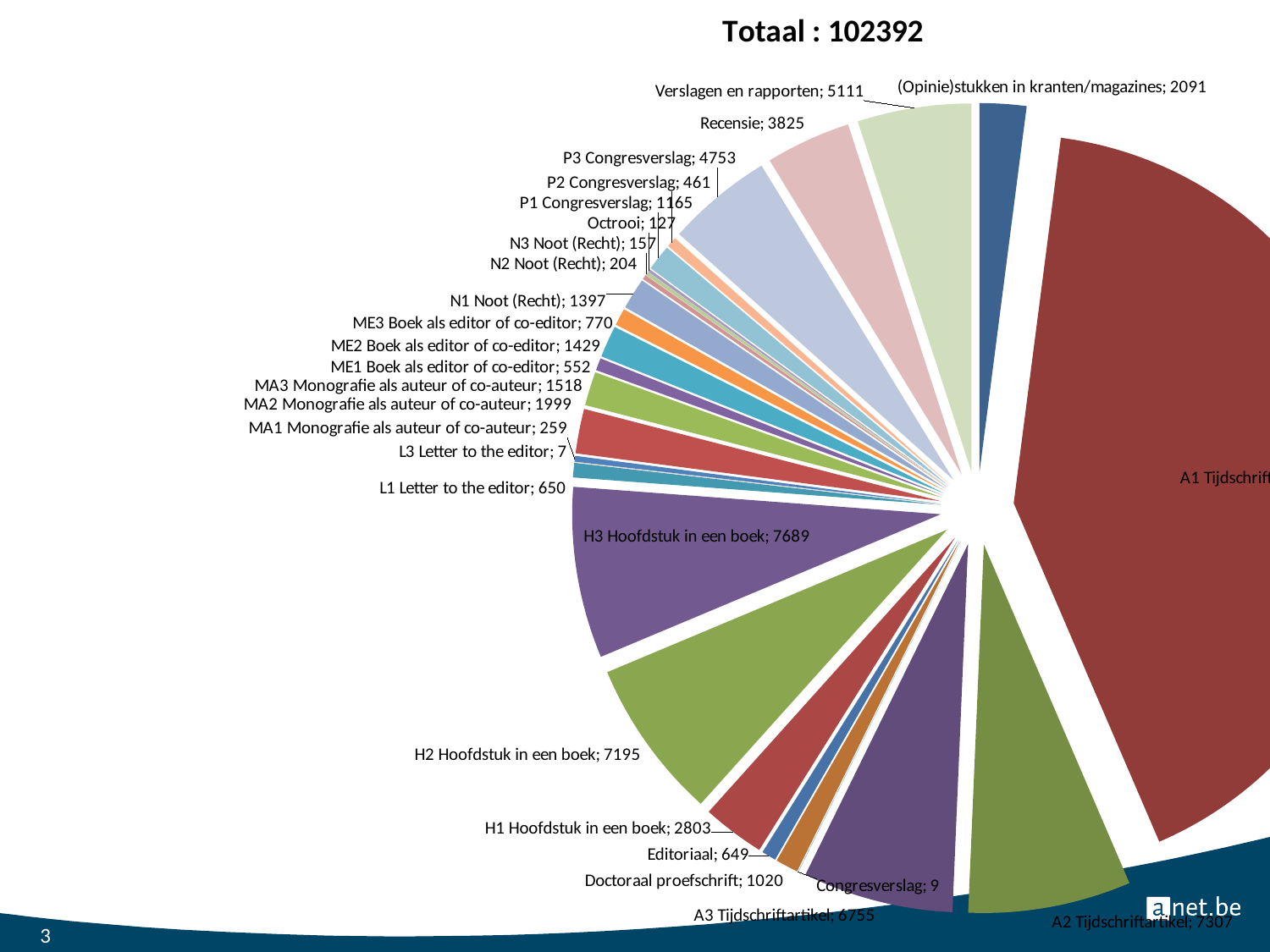
Which is larger, P3 Congresverslag or Recensie? P3 Congresverslag What is the value for Verslagen en rapporten? 5111 What is the value for Doctoraal proefschrift? 1020 What is the value for H3 Hoofdstuk in een boek? 7689 Which category has the smallest value in the pie chart? L3 Letter to the editor What is the difference between H3 Hoofdstuk in een boek and H2 Hoofdstuk in een boek? 494 What type of chart is shown on the slide? Pie chart What is the difference between Verslagen en rapporten and Recensie? 1286 What is the value for MA2 Monografie als auteur of co-auteur? 1999 What is the value for Octrooi? 127 Which category has the largest slice in the pie chart? A1 Tijdschriftartikel What is the title of the chart? Totaal : 102392